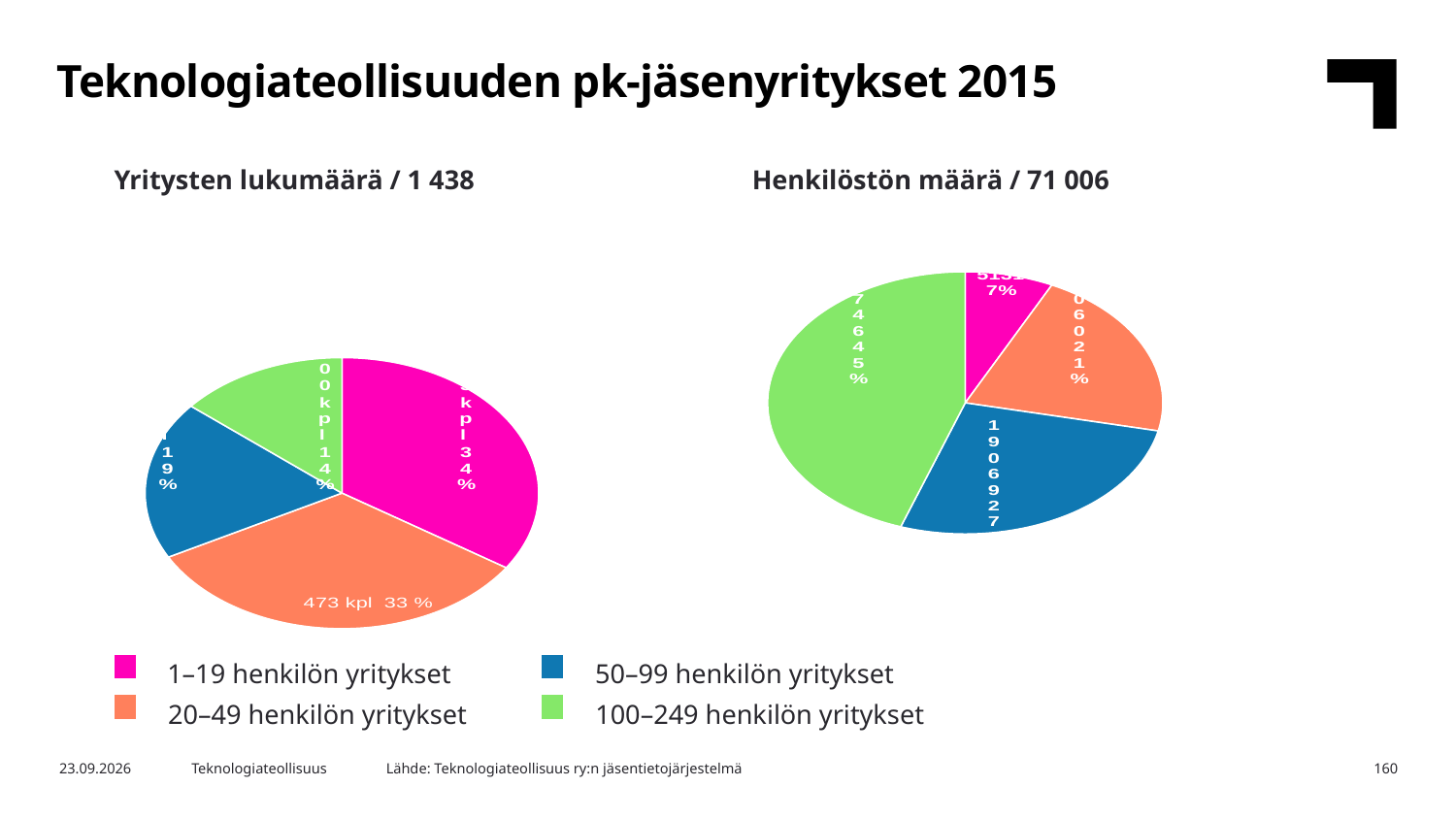
In the 'Yritysten lukumäärä / 1 438' chart, what is the difference in percentage points between the 50–99 and 100–249 henkilön yritykset shares? 5 In the 'Yritysten lukumäärä / 1 438' chart, what share do the 100–249 henkilön yritykset have? 14 % In the 'Yritysten lukumäärä / 1 438' chart, what share do the 20–49 henkilön yritykset have? 33 % How many categories does the legend list? 4 In the 'Yritysten lukumäärä / 1 438' chart, what share do the 50–99 henkilön yritykset have? 19 % What kind of chart is used on this slide for 'Yritysten lukumäärä / 1 438'? Pie chart In the 'Henkilöstön määrä / 71 006' chart, which category has the largest slice? 100–249 henkilön yritykset How many slices does the 'Henkilöstön määrä / 71 006' pie chart have? 4 In the 'Yritysten lukumäärä / 1 438' chart, how many companies (kpl) are in the 20–49 henkilön yritykset slice? 473 kpl In the 'Yritysten lukumäärä / 1 438' chart, which is larger: the share of 50–99 henkilön yritykset or 100–249 henkilön yritykset? 50–99 henkilön yritykset In the 'Yritysten lukumäärä / 1 438' chart, which category has the smallest share? 100–249 henkilön yritykset